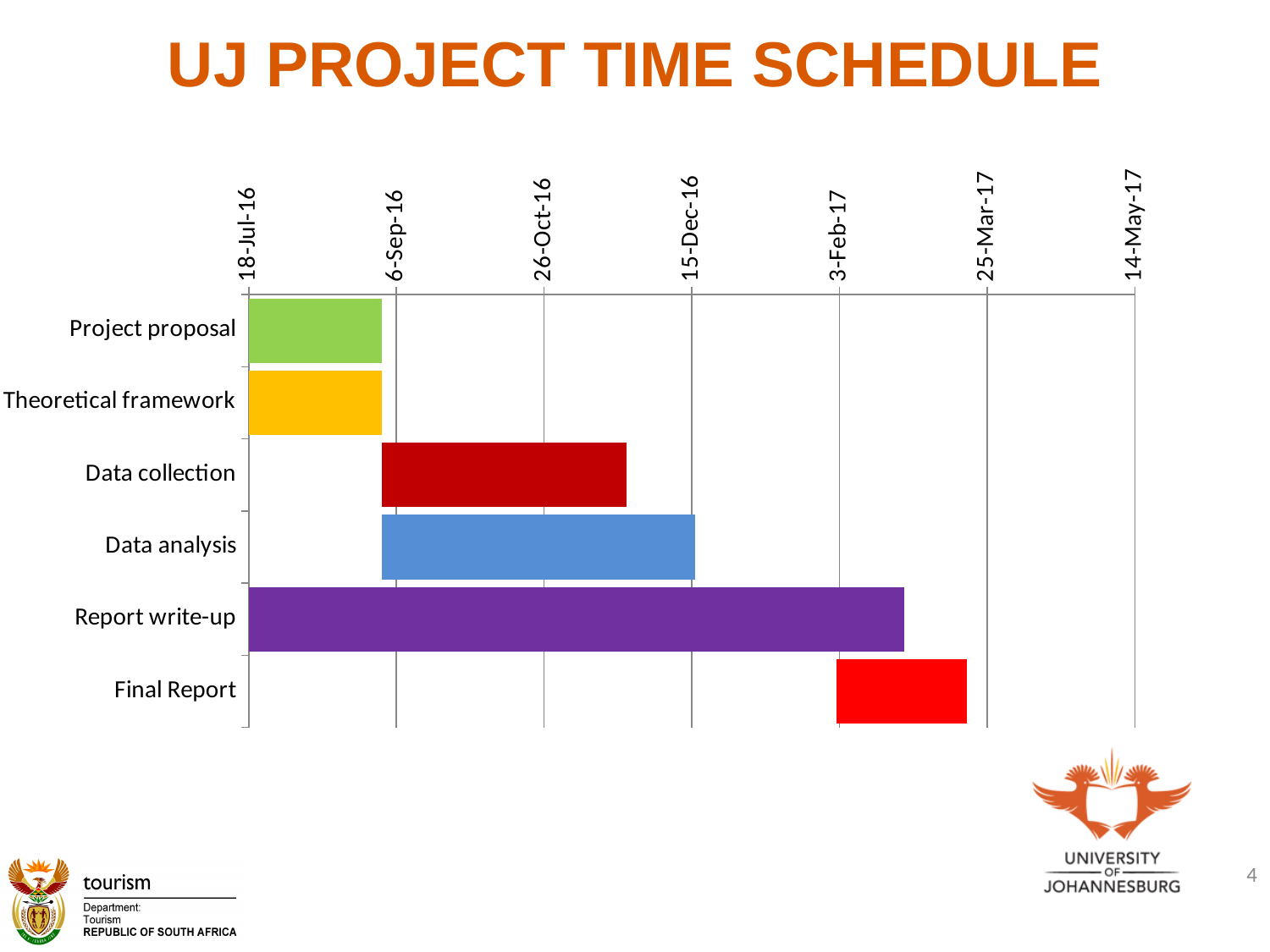
Does the Report write-up bar end before or after 3-Feb-17? after Does the Data collection bar end before or after 26-Oct-16? after What kind of chart is shown on the slide? Bar chart (Gantt chart) What colour is the Report write-up bar? Purple How many tasks are listed on the vertical axis of the chart? 6 Does the Final Report bar end before or after 25-Mar-17? before Which task's bar is longer, Data collection or Data analysis? Data analysis What is the title of the slide containing the chart? UJ PROJECT TIME SCHEDULE Which task has the longest bar in the chart? Report write-up